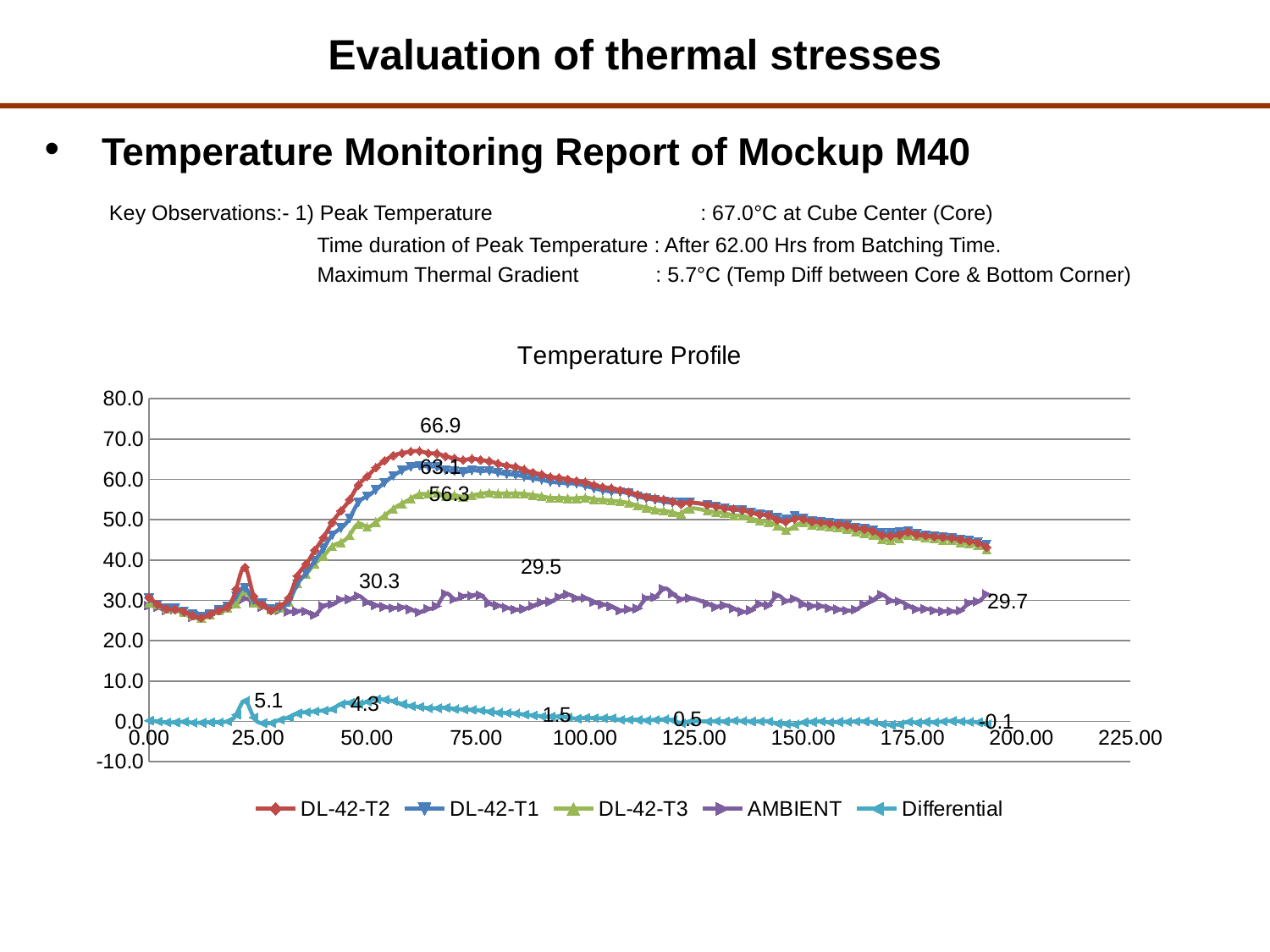
What is the peak value labelled on the DL-42-T2 series in the Temperature Profile chart? 66.9 After its peak near 60 hours, does the DL-42-T2 series rise or fall toward 200.00 on the x axis? fall What is the difference between the labelled peak values of DL-42-T2 (66.9) and DL-42-T3 (56.3)? 10.6 Which series has the lowest values throughout the Temperature Profile chart? Differential What kind of chart is shown under the title 'Temperature Profile'? line chart Is the AMBIENT value at 100.00 on the x axis greater or less than 40? less Which series reaches the highest peak in the Temperature Profile chart? DL-42-T2 What is the last labelled value on the Differential series in the Temperature Profile chart? -0.1 How many series does the legend of the Temperature Profile chart list? 5 What is the peak value labelled on the DL-42-T1 series in the Temperature Profile chart? 63.1 What is the peak value labelled on the DL-42-T3 series in the Temperature Profile chart? 56.3 What is the difference between the labelled peak values of DL-42-T2 (66.9) and DL-42-T1 (63.1)? 3.8